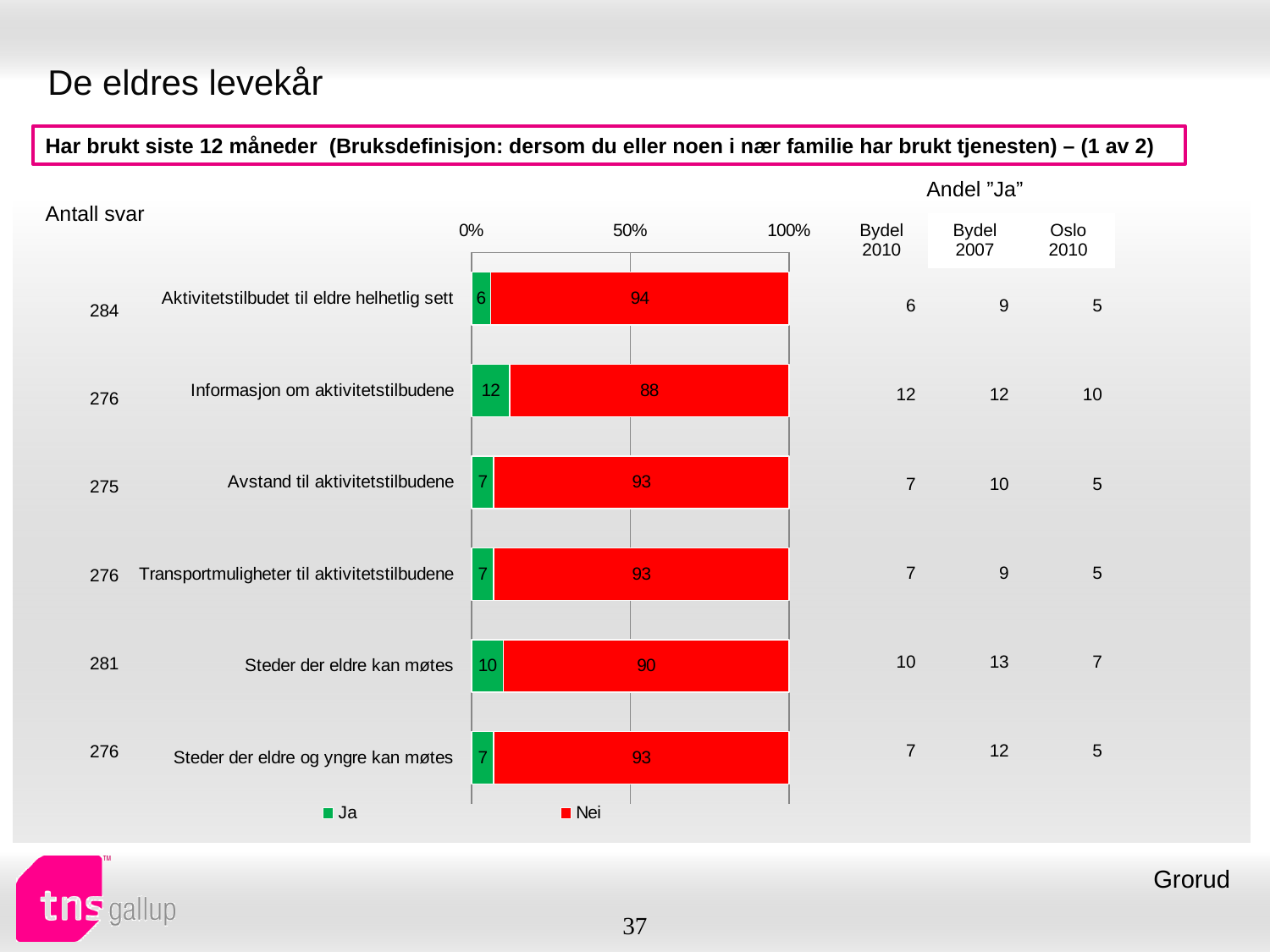
What is the total of the stacked bar for "Avstand til aktivitetstilbudene"? 100 Which category has the highest "Ja" value? Informasjon om aktivitetstilbudene What is the "Ja" value for "Steder der eldre kan møtes"? 10 How many categories are plotted in the chart? 6 Which category has the lowest "Ja" value? Aktivitetstilbudet til eldre helhetlig sett What is the "Nei" value for "Aktivitetstilbudet til eldre helhetlig sett"? 94 What type of chart is shown on the slide? Stacked bar chart How many series does the chart legend list? 2 What is the "Ja" value for "Informasjon om aktivitetstilbudene"? 12 Which is larger: the "Ja" value for "Steder der eldre kan møtes" or for "Steder der eldre og yngre kan møtes"? Steder der eldre kan møtes What is the difference between the "Nei" values for "Aktivitetstilbudet til eldre helhetlig sett" and "Informasjon om aktivitetstilbudene"? 6 Which legend entry is shown in red? Nei